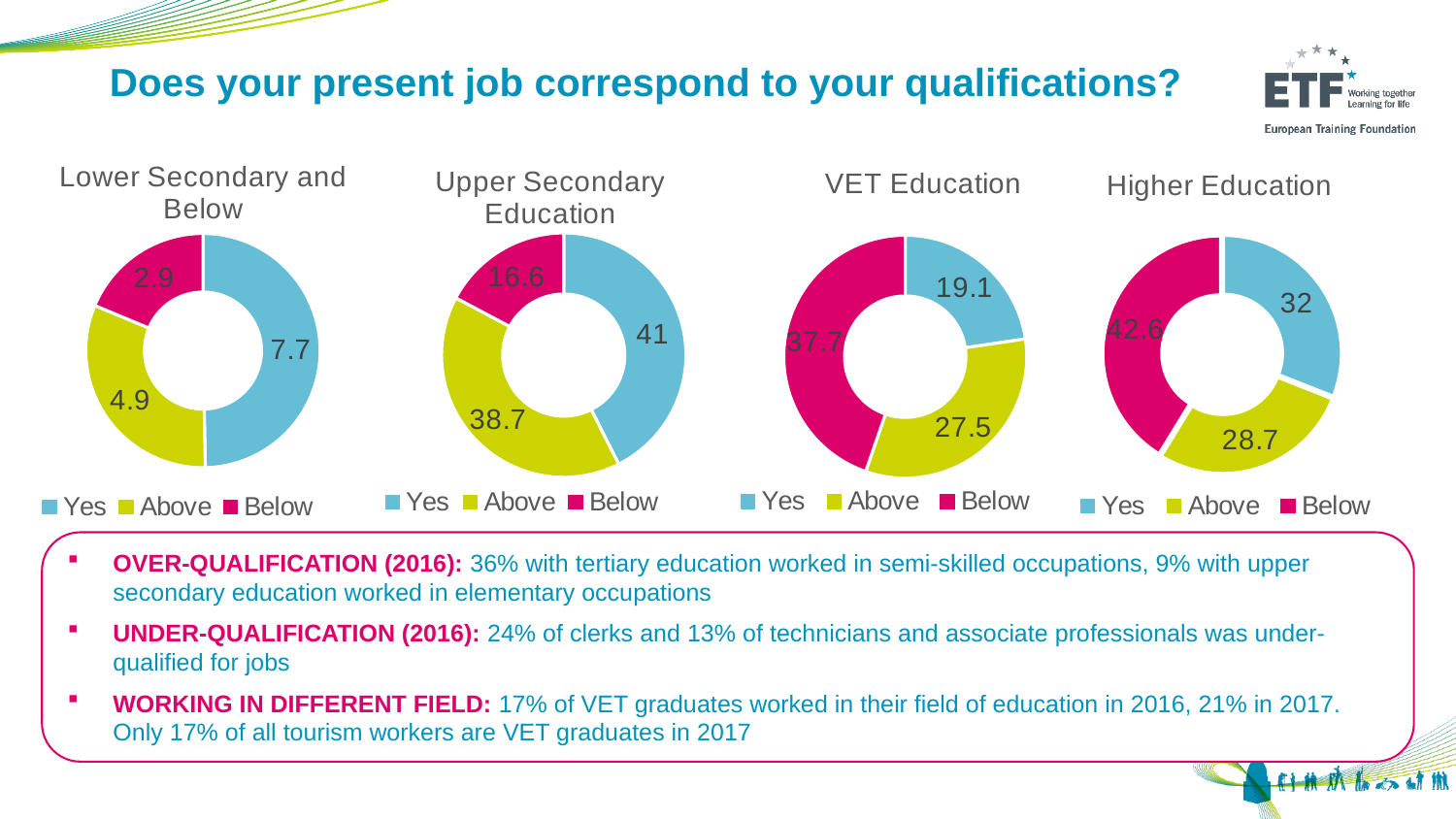
In the VET Education chart, which category has the smallest value? Yes In the Lower Secondary and Below chart, what is the value for Yes? 7.7 In the VET Education chart, which is larger, Yes or Below? Below How many categories does the legend of the Lower Secondary and Below chart list? 3 In the Higher Education chart, which colour represents Above? yellow-green In the Upper Secondary Education chart, what is the difference between the Yes and Above values? 2.3 In the Higher Education chart, what is the value for Below? 42.6 What kind of chart is the Upper Secondary Education chart? doughnut chart In the Higher Education chart, what is the difference between the Below and Yes values? 10.6 In the VET Education chart, what is the value for Above? 27.5 In the Higher Education chart, which category has the largest value? Below In the Upper Secondary Education chart, what is the value for Below? 16.6